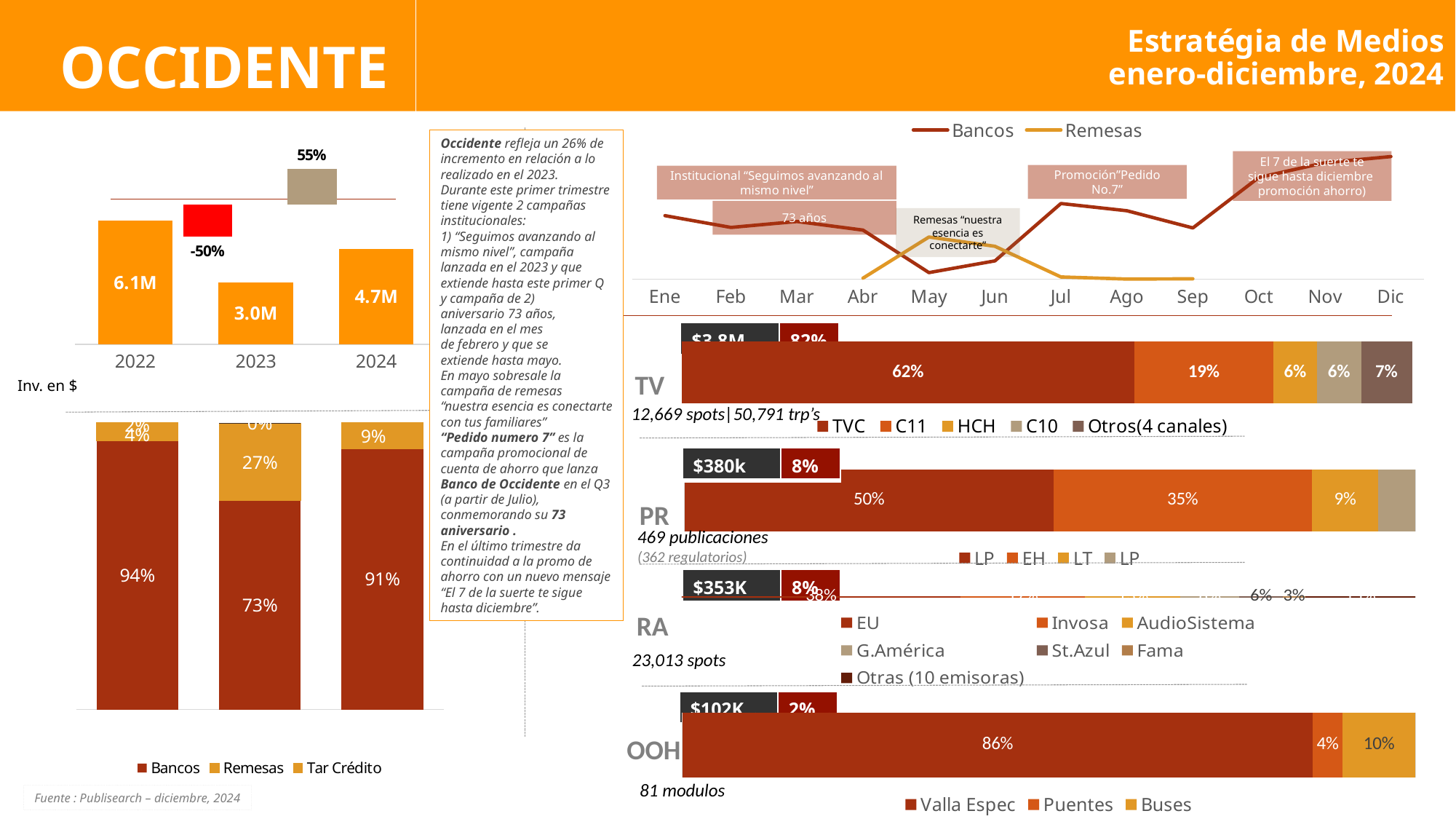
What type of chart is the Bancos vs Remesas chart at the top right? Line chart In the TV bar on the right, what share does TVC have? 62% In the PR bar on the right, which is larger, the first segment (50%) or the second segment (35%)? The first segment (50%) In the 'Inv. en $' bar chart on the left, which year has the lowest investment? 2023 In the 'Inv. en $' bar chart on the left, how many years are plotted? 3 In the stacked bar chart at the bottom left, what is the Bancos share for 2023? 73% In the OOH bar on the right, what share does Buses have? 10% In the 'Inv. en $' bar chart on the left, what is the value for 2022? 6.1M In the stacked bar chart at the bottom left, what is the Remesas share for 2024? 9% In the TV bar on the right, what is the difference between the TVC share and the C11 share? 43% In the stacked bar chart at the bottom left, how many series does the legend list? 3 In the 'Inv. en $' bar chart on the left, what percentage change is shown for 2024? 55%